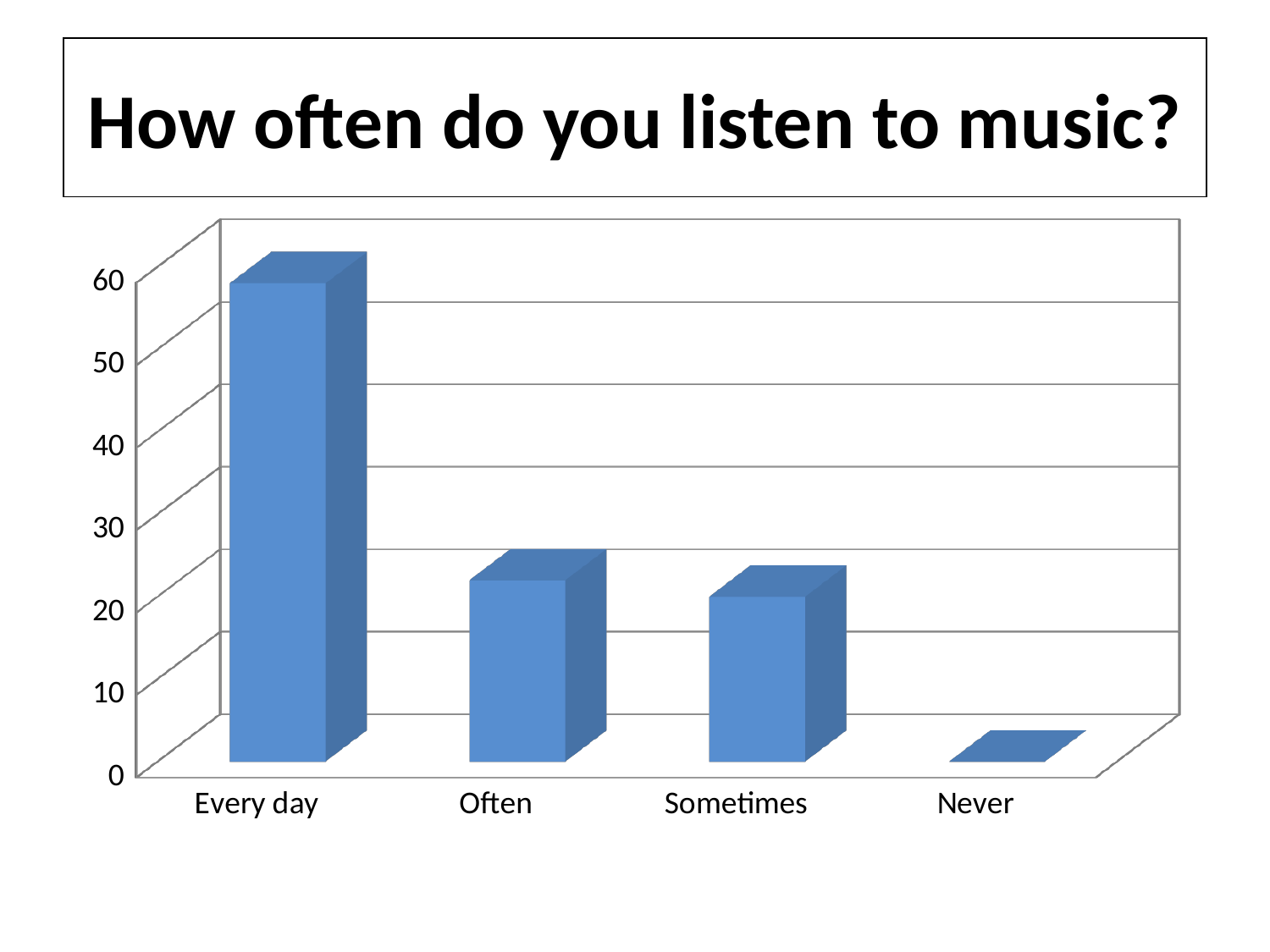
Is the value for Every day greater or less than 40? greater Do the values generally rise or fall moving from Every day to Never along the x axis? fall What kind of chart is shown on the slide? bar chart Which category has the highest bar in the chart? Every day How many categories are shown on the x axis of the chart? 4 Which is larger, the value for Every day or the value for Sometimes? Every day Is the value for Sometimes greater or less than 10? greater Is the value for Often greater or less than 30? less What is the title of the slide containing the chart? How often do you listen to music? Which is larger, the value for Often or the value for Never? Often What is the value for Never in the chart? 0 Which category has the lowest bar in the chart? Never